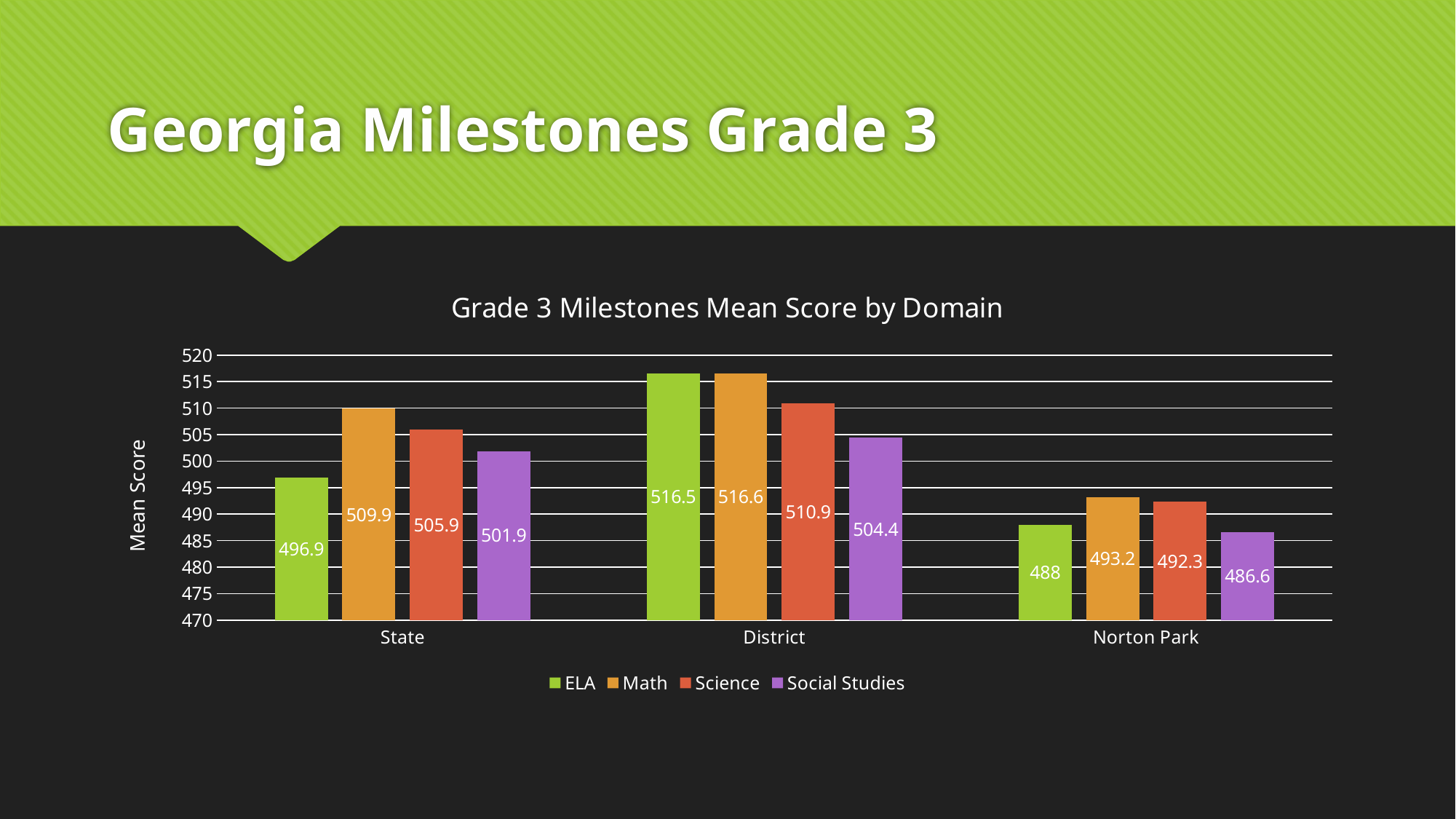
How many series does the legend list? 4 What is the Science mean score for Norton Park? 492.3 Which group has the highest Science mean score? District What is the ELA mean score for the State? 496.9 Which group has the lowest Social Studies mean score? Norton Park What is the Math mean score for the District? 516.6 Which is larger, the State Math score or the State Science score? State Math score How many groups are shown on the x axis? 3 Is the Norton Park ELA mean score greater or less than 490? less What type of chart is shown? Bar chart What is the Social Studies mean score for Norton Park? 486.6 What is the difference between the District and Norton Park ELA mean scores? 28.5